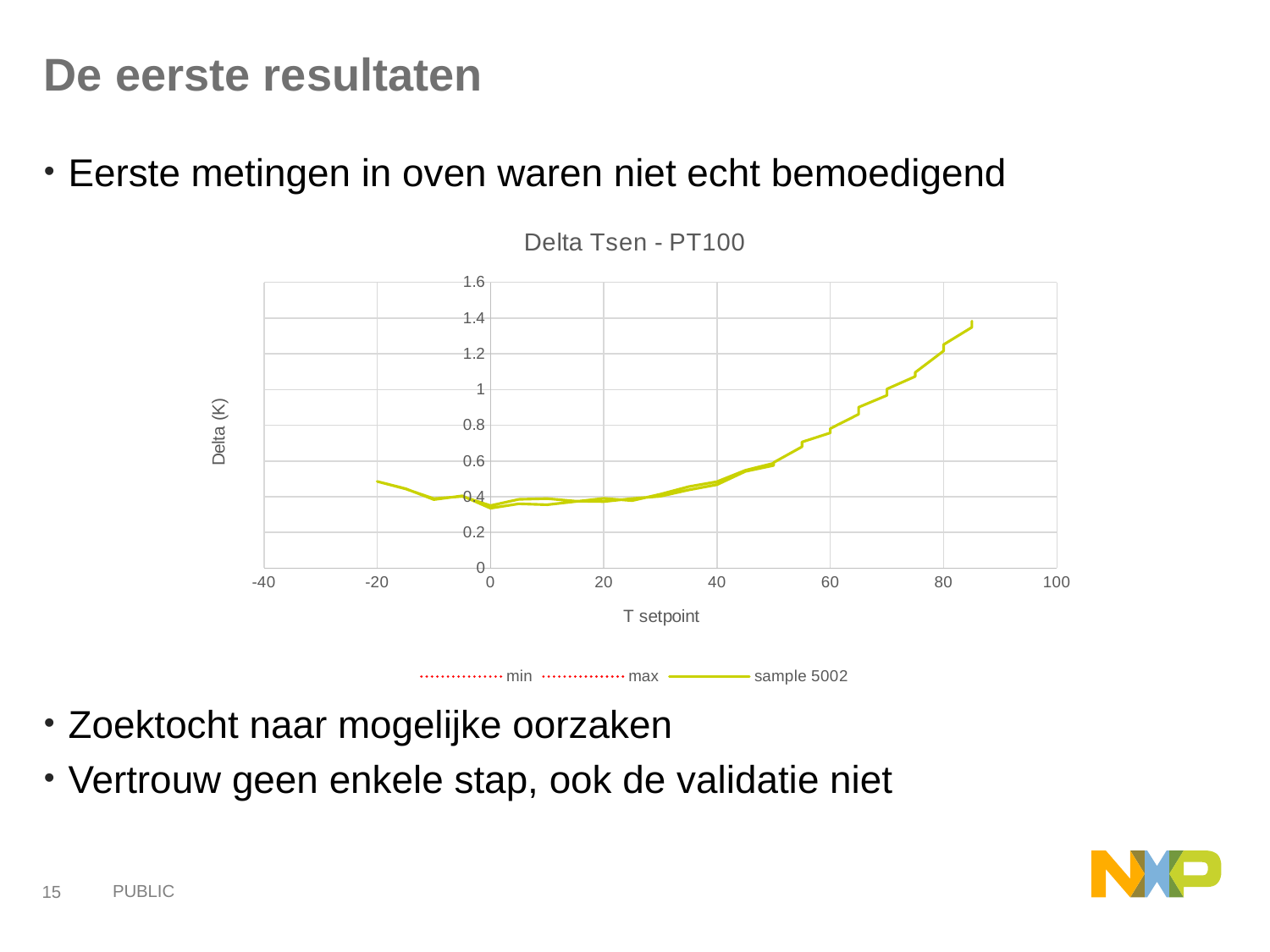
Is the value of sample 5002 at T setpoint 20 greater or less than 0.6? less Is the value of sample 5002 at T setpoint 80 greater or less than 1? greater What is the label of the y axis of the chart? Delta (K) Between T setpoint 20 and T setpoint 80, does the sample 5002 line rise or fall? rises What is the title of the chart? Delta Tsen - PT100 Is the value of sample 5002 at T setpoint -20 greater or less than 0.8? less How many series does the chart legend list? 3 Is the value of sample 5002 larger at T setpoint 80 or at T setpoint 20? 80 What kind of chart is shown on the slide? line chart Is the highest value of the sample 5002 line at the left end or the right end of the line? right end